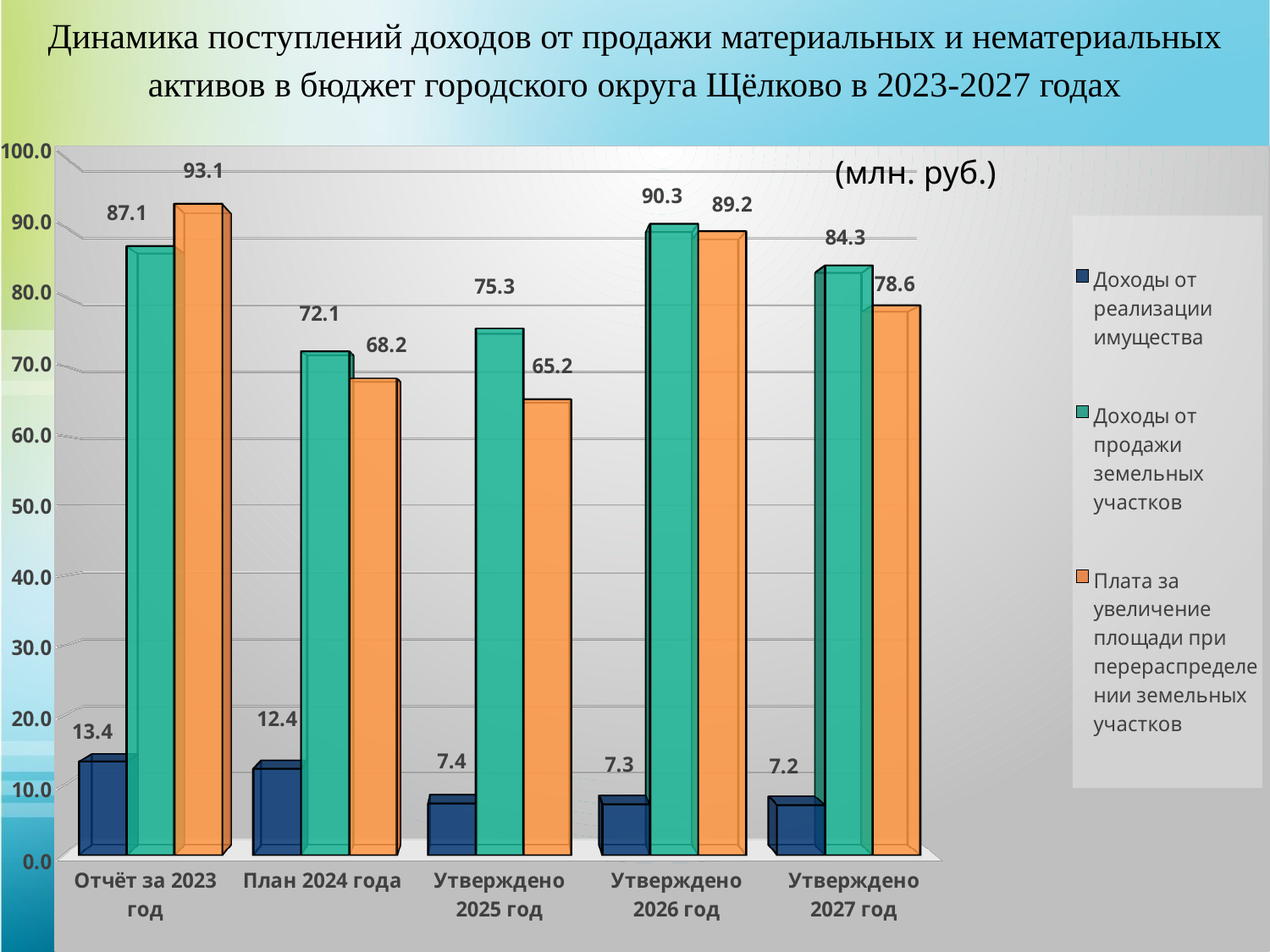
Сколько рядов данных перечислено в легенде диаграммы? 3 Что больше в категории «Утверждено 2027 год»: «Доходы от продажи земельных участков» или «Плата за увеличение площади при перераспределении земельных участков»? Доходы от продажи земельных участков Какое значение показателя «Плата за увеличение площади при перераспределении земельных участков» в категории «Утверждено 2026 год»? 89.2 В какой категории показатель «Плата за увеличение площади при перераспределении земельных участков» наименьший? Утверждено 2025 год Сколько категорий показано на оси X диаграммы? 5 Какого типа эта диаграмма? Столбчатая (bar chart) В какой категории показатель «Доходы от продажи земельных участков» наибольший? Утверждено 2026 год На сколько значение «Плата за увеличение площади при перераспределении земельных участков» в категории «Отчёт за 2023 год» больше значения «Доходы от продажи земельных участков» в той же категории? 6.0 Как изменяется показатель «Доходы от реализации имущества» от категории «Отчёт за 2023 год» к категории «Утверждено 2027 год»? Снижается Какое значение показателя «Доходы от продажи земельных участков» в категории «Отчёт за 2023 год»? 87.1 Значение «Доходы от реализации имущества» в категории «Утверждено 2025 год» больше или меньше 10.0? меньше Какое значение показателя «Доходы от реализации имущества» в категории «План 2024 года»? 12.4